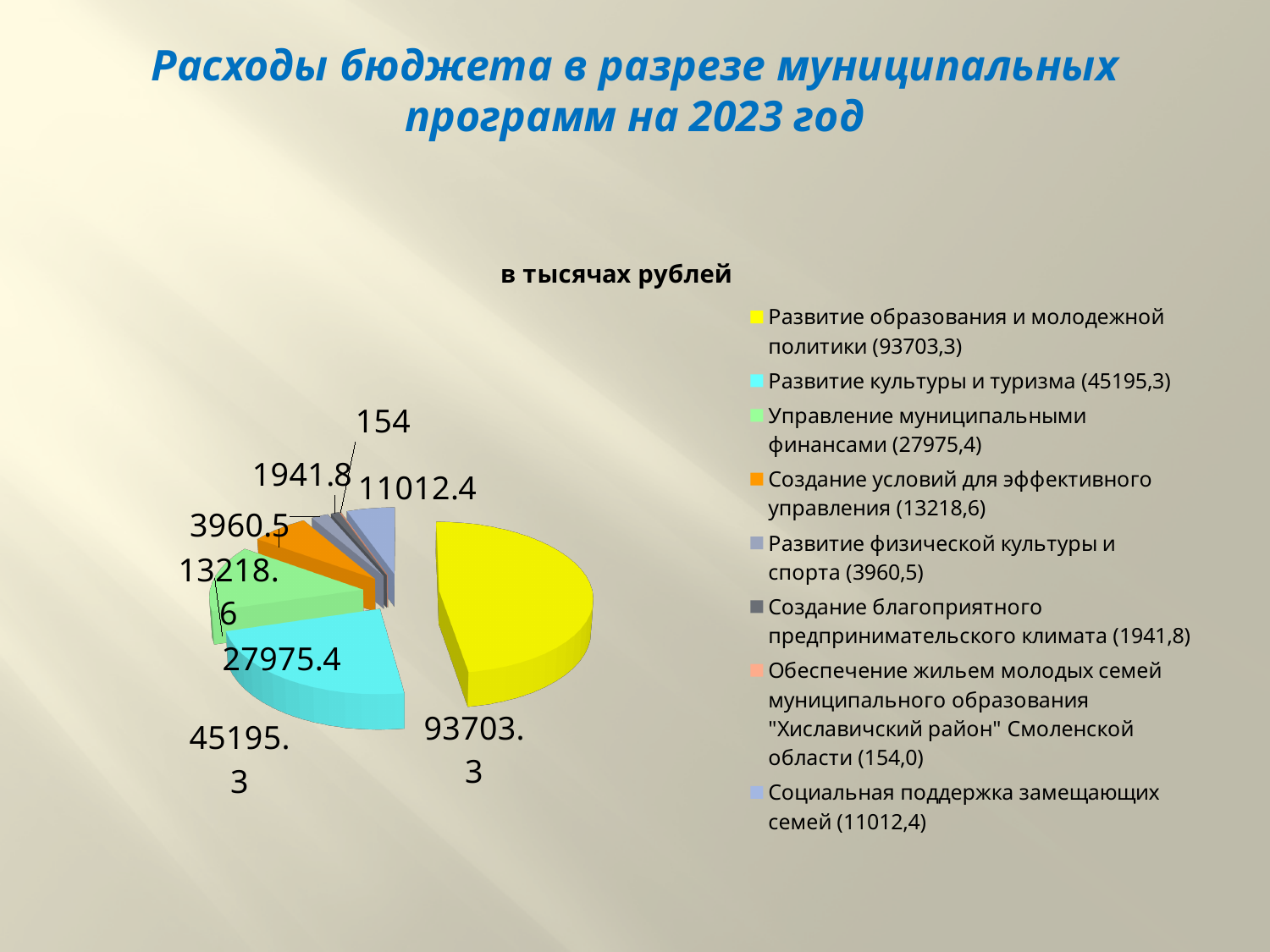
What unit is stated above the chart? в тысячах рублей What is the value for Создание благоприятного предпринимательского климата? 1941.8 What is the value for Развитие культуры и туризма? 45195.3 How many entries does the legend list? 8 What is the difference between the values for Развитие образования и молодежной политики and Развитие культуры и туризма? 48508 Which program has the smallest share of the pie? Обеспечение жильем молодых семей муниципального образования "Хиславичский район" Смоленской области What is the value for Социальная поддержка замещающих семей? 11012.4 Which is larger: Управление муниципальными финансами or Создание условий для эффективного управления? Управление муниципальными финансами What kind of chart is shown on the slide? pie chart How many slices does the pie chart have? 8 What is the value for Развитие образования и молодежной политики? 93703.3 Which program has the largest share of the pie? Развитие образования и молодежной политики